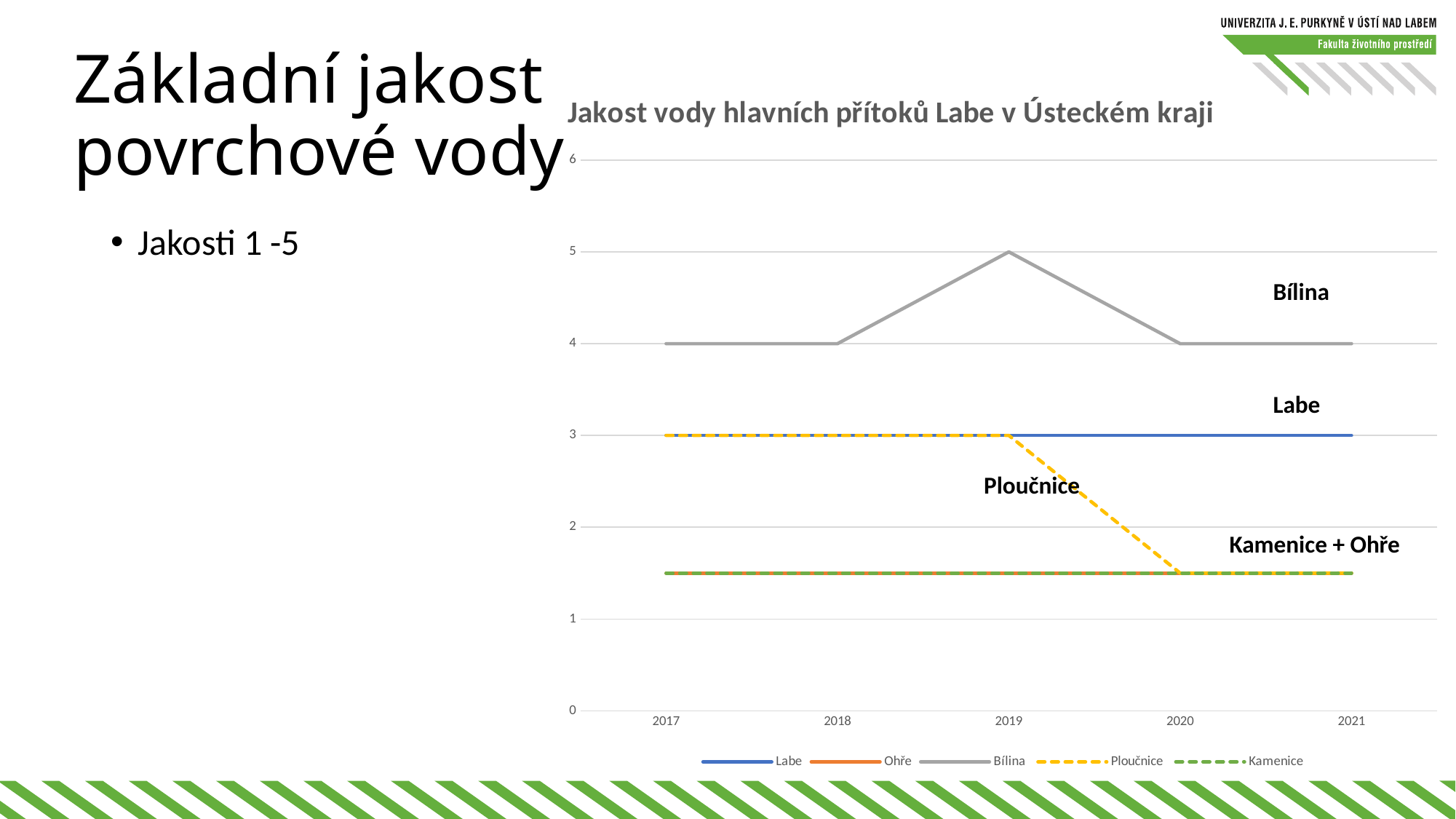
Is the value for Kamenice in 2017 greater or less than 2? less How many series does the legend list? 5 What type of chart is shown on the slide? line chart Which series has the highest value in 2019? Bílina What is the title of the chart? Jakost vody hlavních přítoků Labe v Ústeckém kraji What is the value for Labe in 2021? 3 Does the Ploučnice line rise or fall between 2019 and 2020? fall What is the difference between the Bílina value and the Labe value in 2019? 2 How many years are shown on the x axis? 5 What is the value for Bílina in 2017? 4 In which year does Bílina reach its highest value? 2019 What is the value for Bílina in 2019? 5